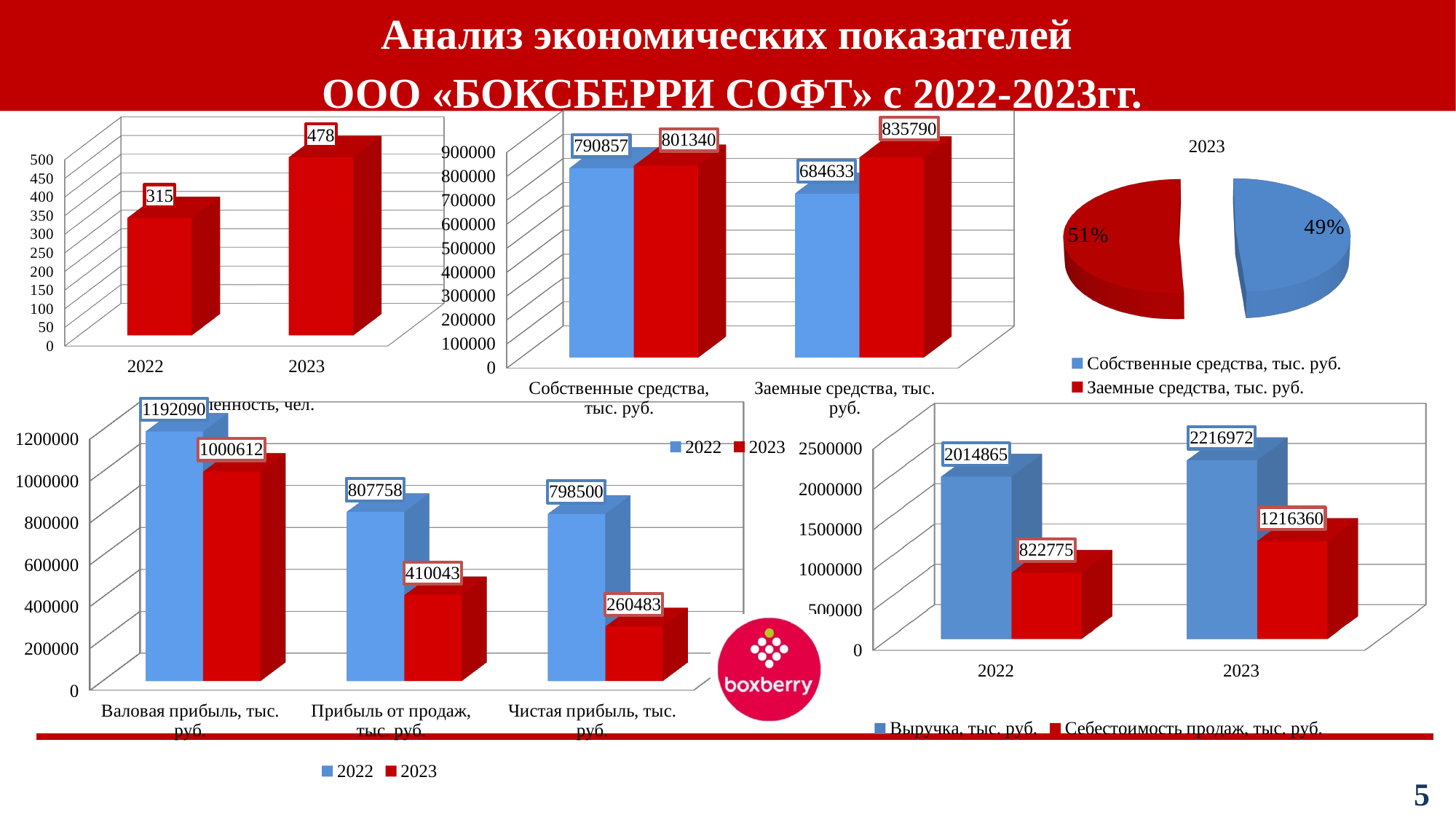
In the top-left bar chart, what is the difference between the 2023 and 2022 values? 163 In the top-left bar chart, what is the value for 2023? 478 How many series does the legend of the bottom-right bar chart list? 2 In the top-middle bar chart, which is larger for Заемные средства, тыс. руб.: the 2022 value or the 2023 value? 2023 In the top-middle bar chart, what is the 2022 value for Собственные средства, тыс. руб.? 790857 What kind of chart is the top-right chart? Pie chart In the bottom-left bar chart, what is the 2023 value for Чистая прибыль, тыс. руб.? 260483 In the bottom-left bar chart, which category has the highest 2022 value? Валовая прибыль, тыс. руб. In the top-right pie chart, what share does Заемные средства, тыс. руб. have? 51% In the top-middle bar chart, what is the 2023 value for Заемные средства, тыс. руб.? 835790 In the bottom-left bar chart, what is the difference between the 2022 and 2023 values for Прибыль от продаж, тыс. руб.? 397715 In the bottom-right bar chart, what is the value for Выручка, тыс. руб. in 2023? 2216972